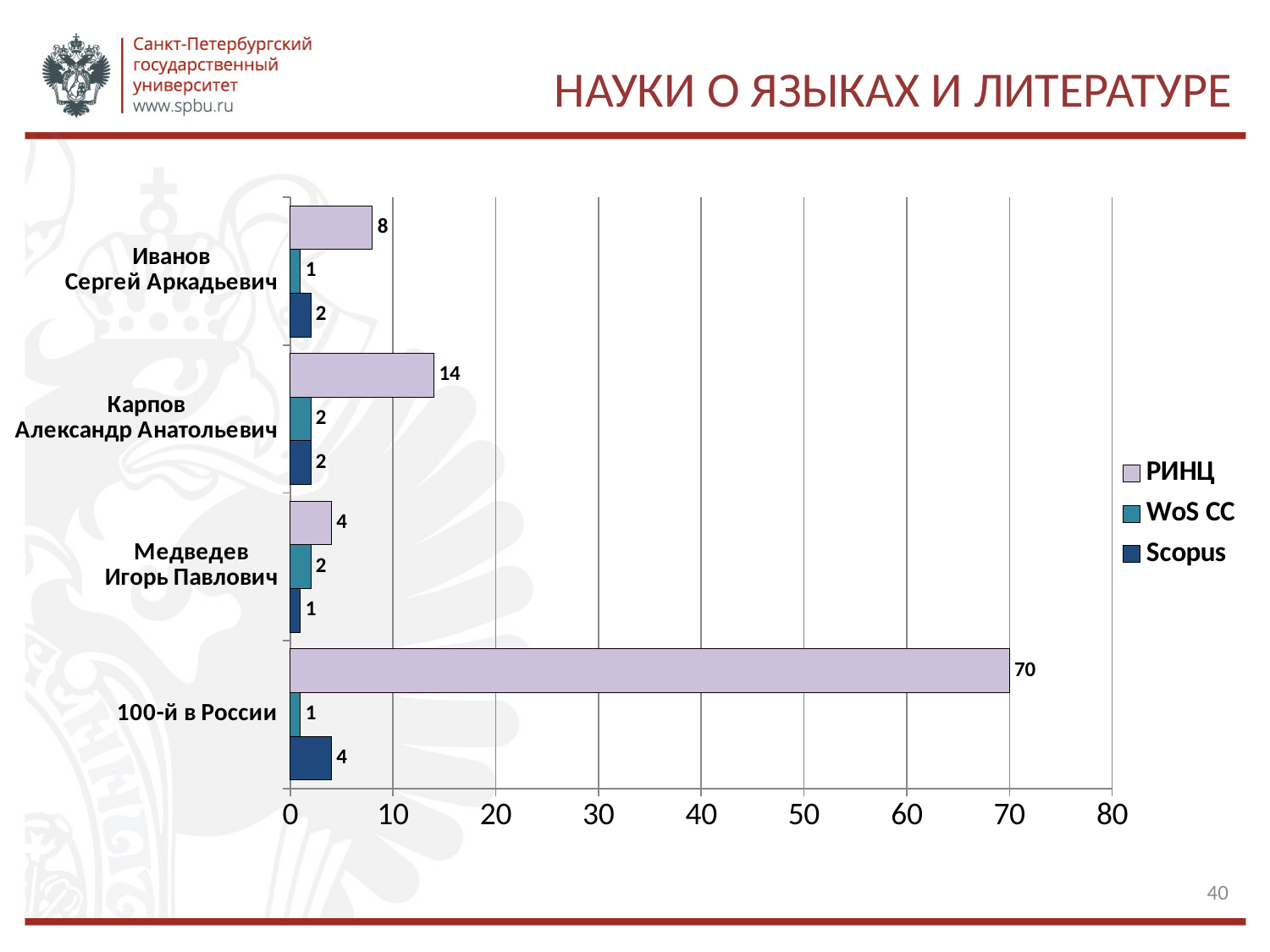
What is the РИНЦ value for Иванов Сергей Аркадьевич? 8 How many series does the legend list? 3 What is the Scopus value for 100-й в России? 4 What is the difference between the РИНЦ values for 100-й в России and Карпов Александр Анатольевич? 56 What kind of chart is shown on the slide? Bar chart Which category has the lowest Scopus value? Медведев Игорь Павлович What is the РИНЦ value for Медведев Игорь Павлович? 4 What is the title of the slide? НАУКИ О ЯЗЫКАХ И ЛИТЕРАТУРЕ How many categories are shown on the chart? 4 Which category has the highest РИНЦ value? 100-й в России Which is larger: the РИНЦ value for Карпов Александр Анатольевич or for Иванов Сергей Аркадьевич? Карпов Александр Анатольевич What is the WoS CC value for Карпов Александр Анатольевич? 2